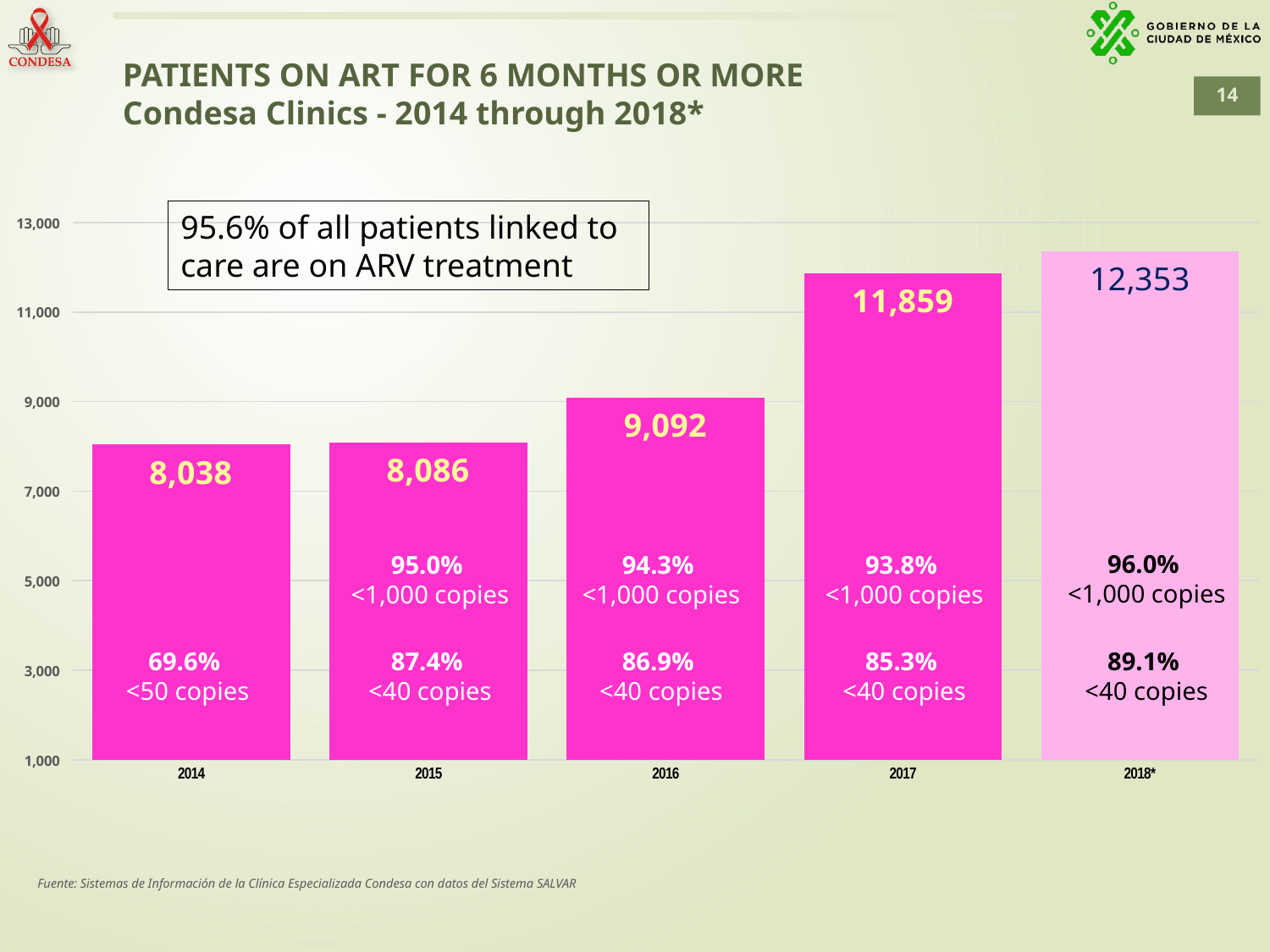
Which year has more patients on ART: 2016 or 2017? 2017 Which year has the lowest number of patients on ART for 6 months or more? 2014 What percentage of patients had <1,000 copies in 2016? 94.3% What is the difference in patients on ART between 2016 and 2015? 1,006 How many years are shown on the x axis of the chart? 5 What is the number of patients on ART for 6 months or more in 2017? 11,859 What kind of chart is shown on the slide? bar chart What is the number of patients on ART for 6 months or more in 2014? 8,038 What percentage of patients had <40 copies in 2018*? 89.1% Do the numbers of patients on ART rise or fall from 2014 to 2018*? rise Which year has the highest number of patients on ART for 6 months or more? 2018* What is the difference in patients on ART between 2018* and 2017? 494